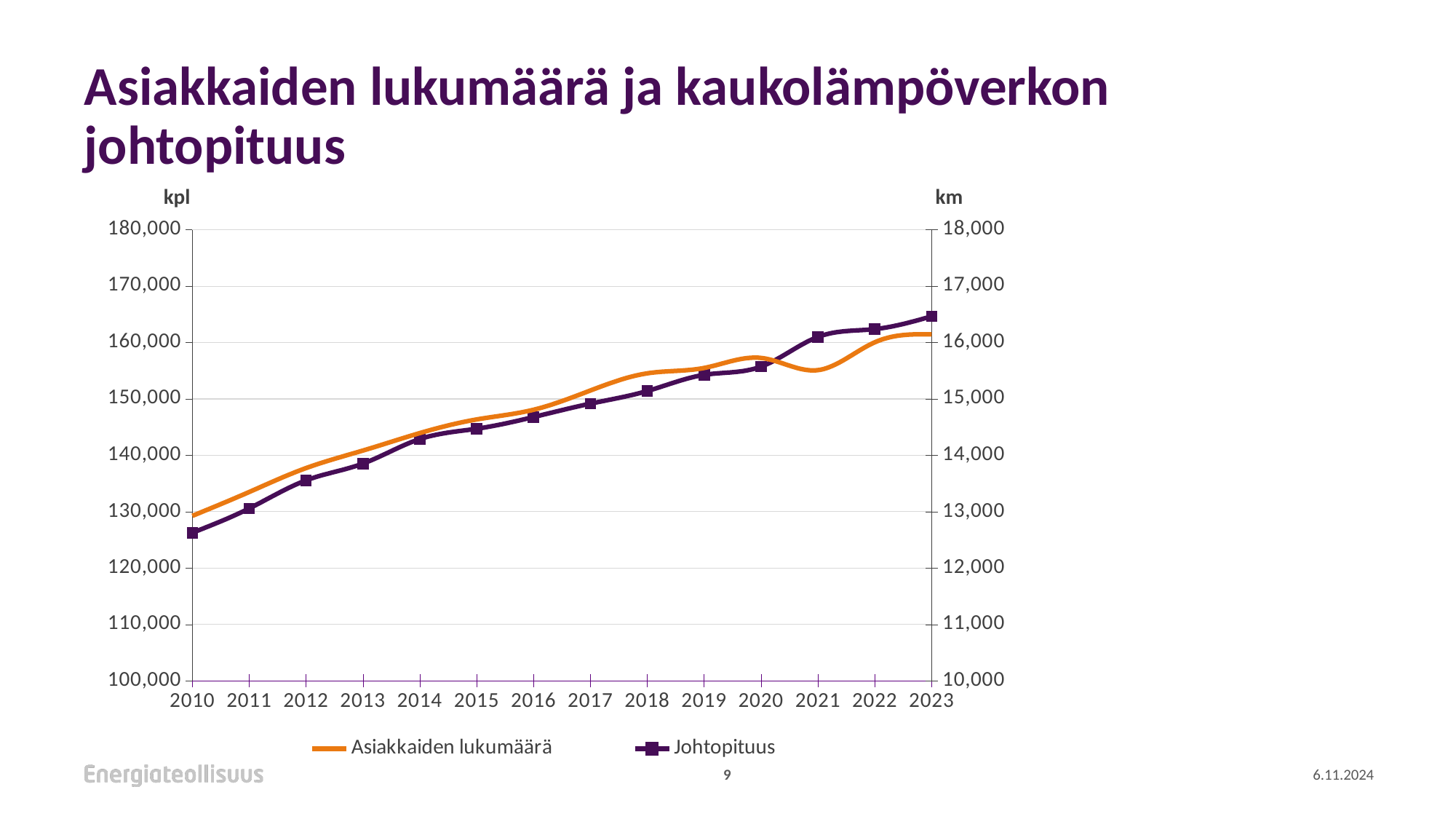
In which year is Johtopituus lowest? 2010 In which year is Asiakkaiden lukumäärä lowest? 2010 Is the value for Asiakkaiden lukumäärä in 2010 greater or less than 140,000? less How many series does the legend list? 2 What unit is shown on the right-hand axis? km Is the value for Asiakkaiden lukumäärä in 2018 greater or less than 150,000? greater In which year is Johtopituus highest? 2023 How many years are shown on the x axis? 14 What kind of chart is shown on the slide? line chart Is the value for Johtopituus in 2023 greater or less than 16,000? greater Does the Johtopituus series rise or fall from 2010 to 2023? rise